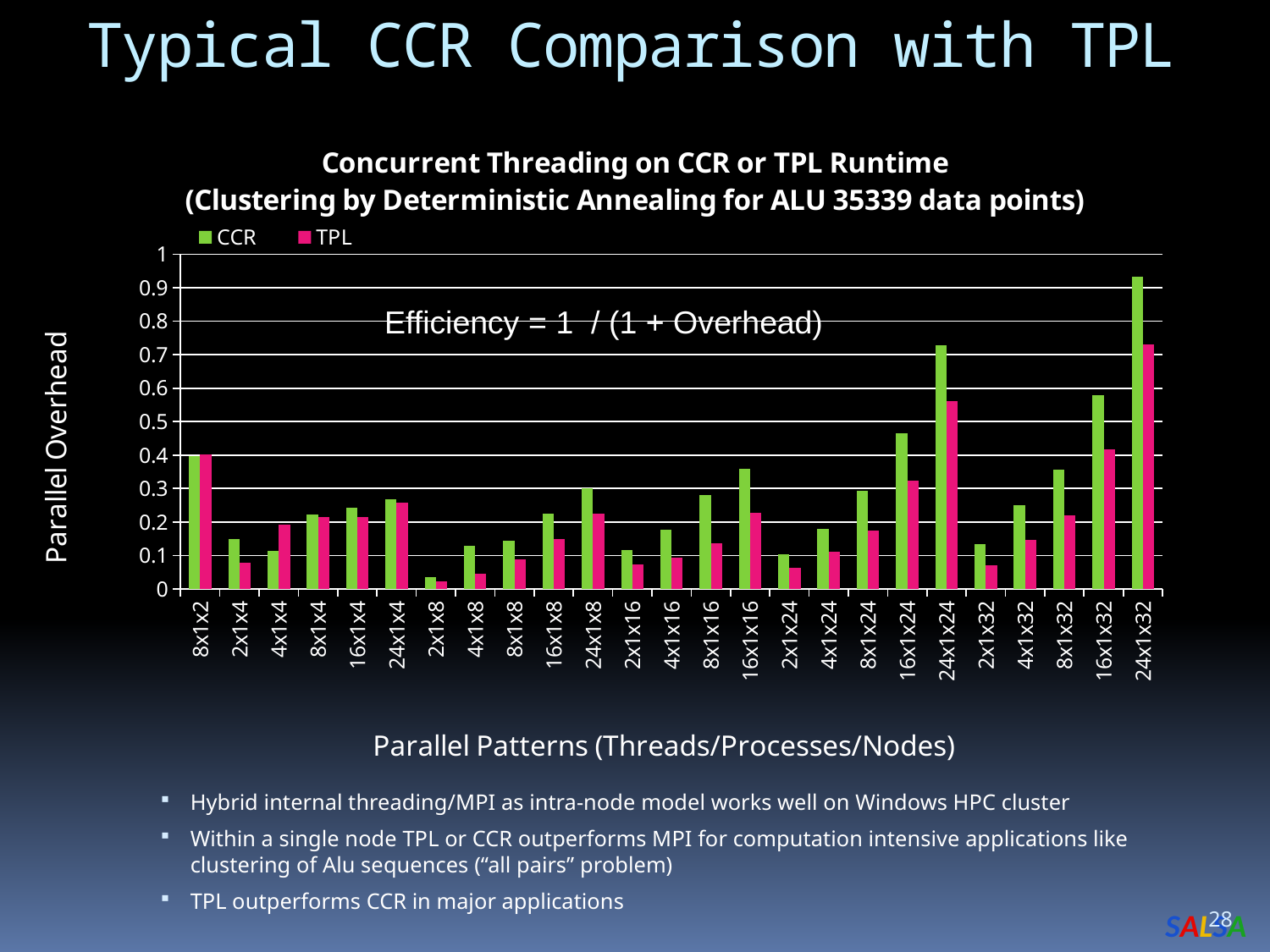
Is the CCR parallel overhead for 16x1x24 greater or less than 0.4? greater For the 4x1x4 pattern, which series has the larger parallel overhead, CCR or TPL? TPL What kind of chart is shown on the slide? bar chart Is the TPL parallel overhead for 24x1x24 greater or less than 0.5? greater Is the CCR parallel overhead for 2x1x8 greater or less than 0.1? less For the 16x1x32 pattern, which series has the larger parallel overhead, CCR or TPL? CCR Which parallel pattern has the lowest CCR parallel overhead? 2x1x8 How many series does the chart legend list? 2 Which parallel pattern has the highest TPL parallel overhead? 24x1x32 Which parallel pattern has the highest CCR parallel overhead? 24x1x32 How many parallel pattern categories are shown on the x axis? 25